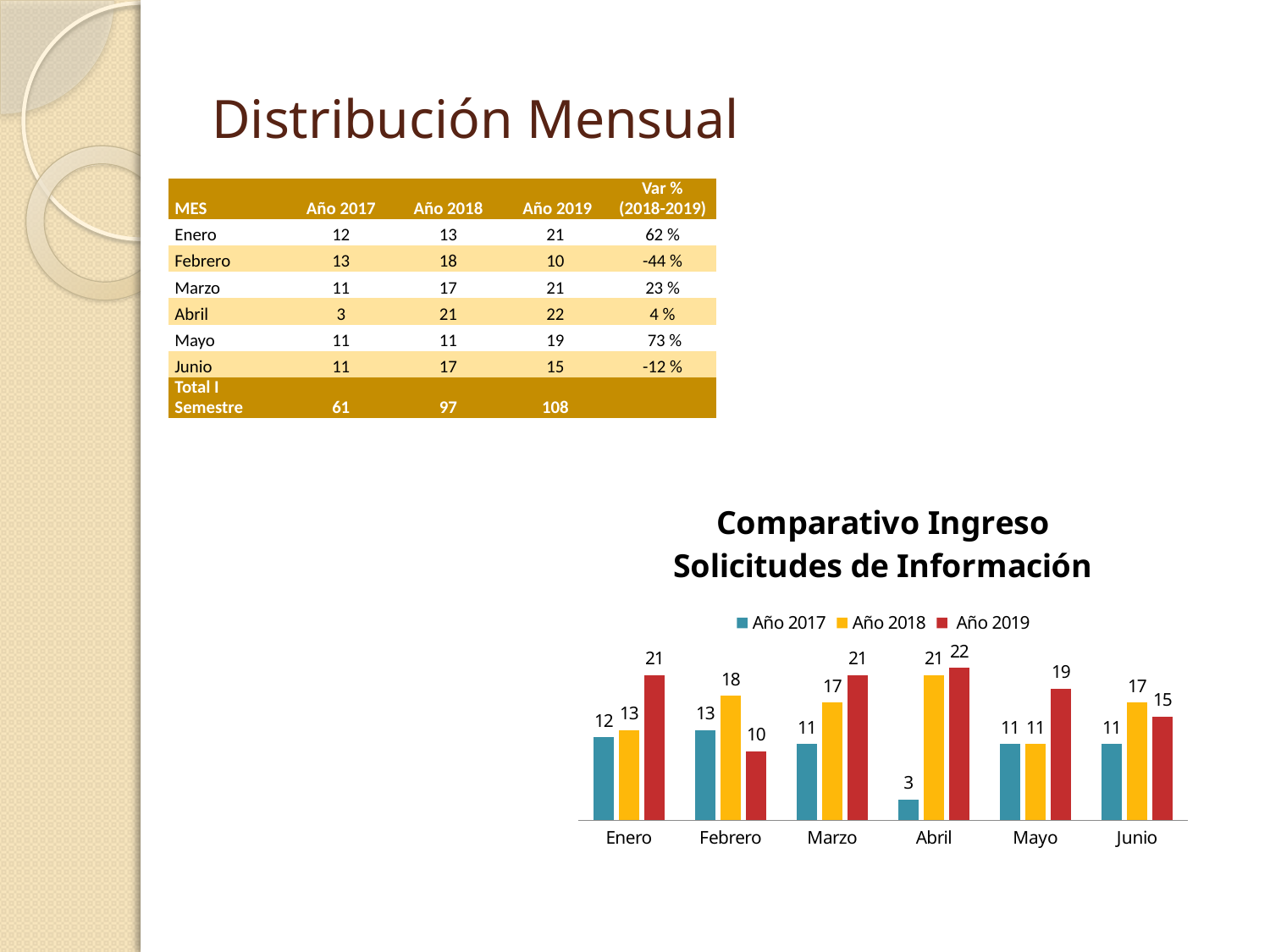
What type of chart is shown on the slide? bar chart How many series does the chart legend list? 3 What is the value for Año 2019 in Abril? 22 What is the difference between Año 2019 and Año 2018 in Mayo? 8 Which month has the lowest value for Año 2017? Abril What is the value for Año 2017 in Abril? 3 What is the value for Año 2018 in Febrero? 18 What is the title of the chart? Comparativo Ingreso Solicitudes de Información Which is larger in Febrero, Año 2018 or Año 2019? Año 2018 Which colour represents Año 2019 in the chart? red How many months are shown on the x axis of the chart? 6 Which month has the highest value for Año 2019? Abril